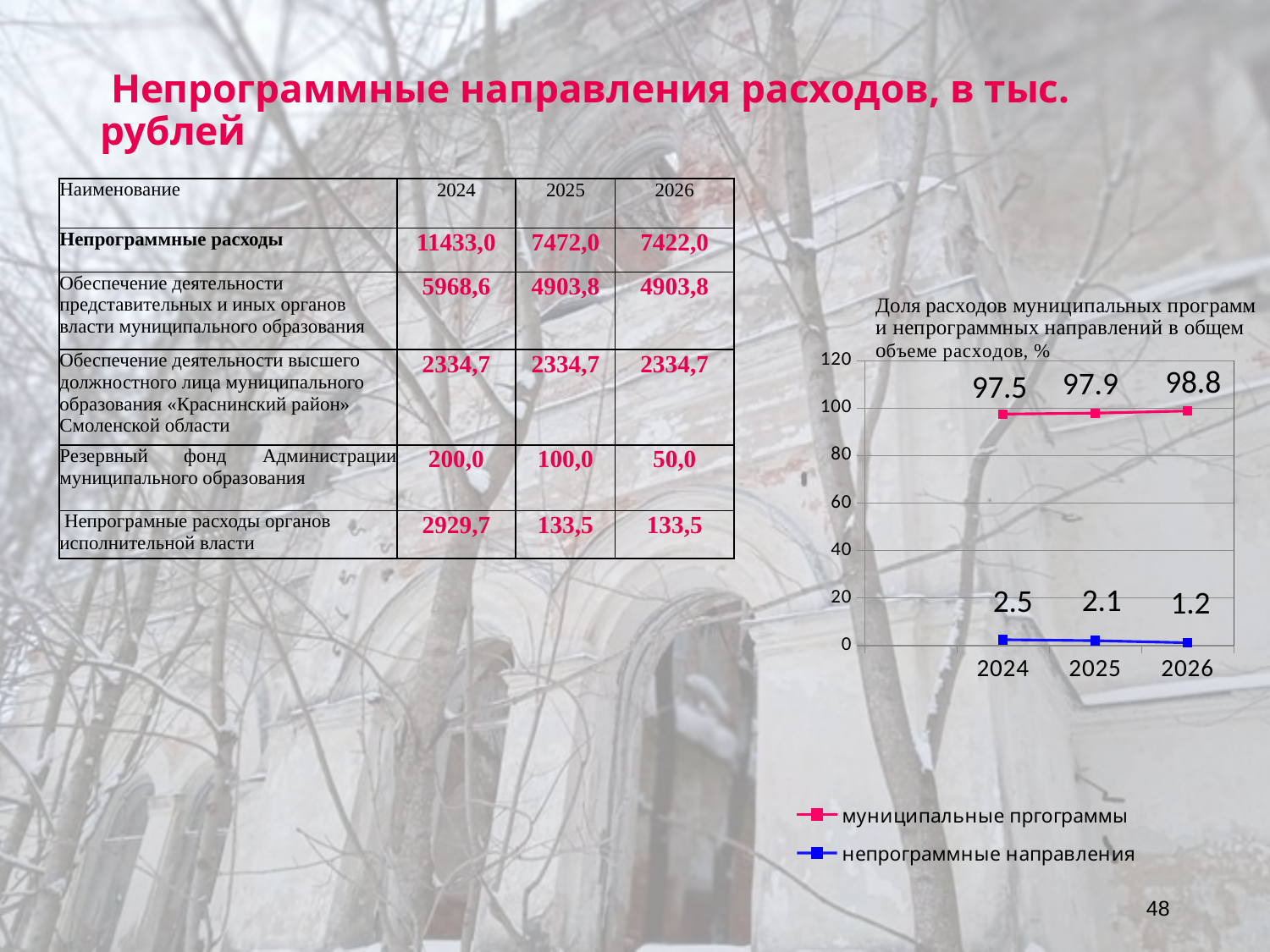
Does the value for непрограммные направления rise or fall from 2024 to 2026? fall What type of chart is shown on the slide? line chart What is the difference between the муниципальные прграммы values for 2026 and 2024? 1.3 How many series does the chart legend list? 2 In which year is the value for непрограммные направления lowest? 2026 What is the value for непрограммные направления in 2025? 2.1 In which year is the value for муниципальные прграммы highest? 2026 What is the value for непрограммные направления in 2026? 1.2 What is the value for муниципальные прграммы in 2024? 97.5 How many years are shown on the x axis of the chart? 3 Which is larger in 2025: the value for муниципальные прграммы or for непрограммные направления? муниципальные прграммы What is the value for муниципальные прграммы in 2026? 98.8